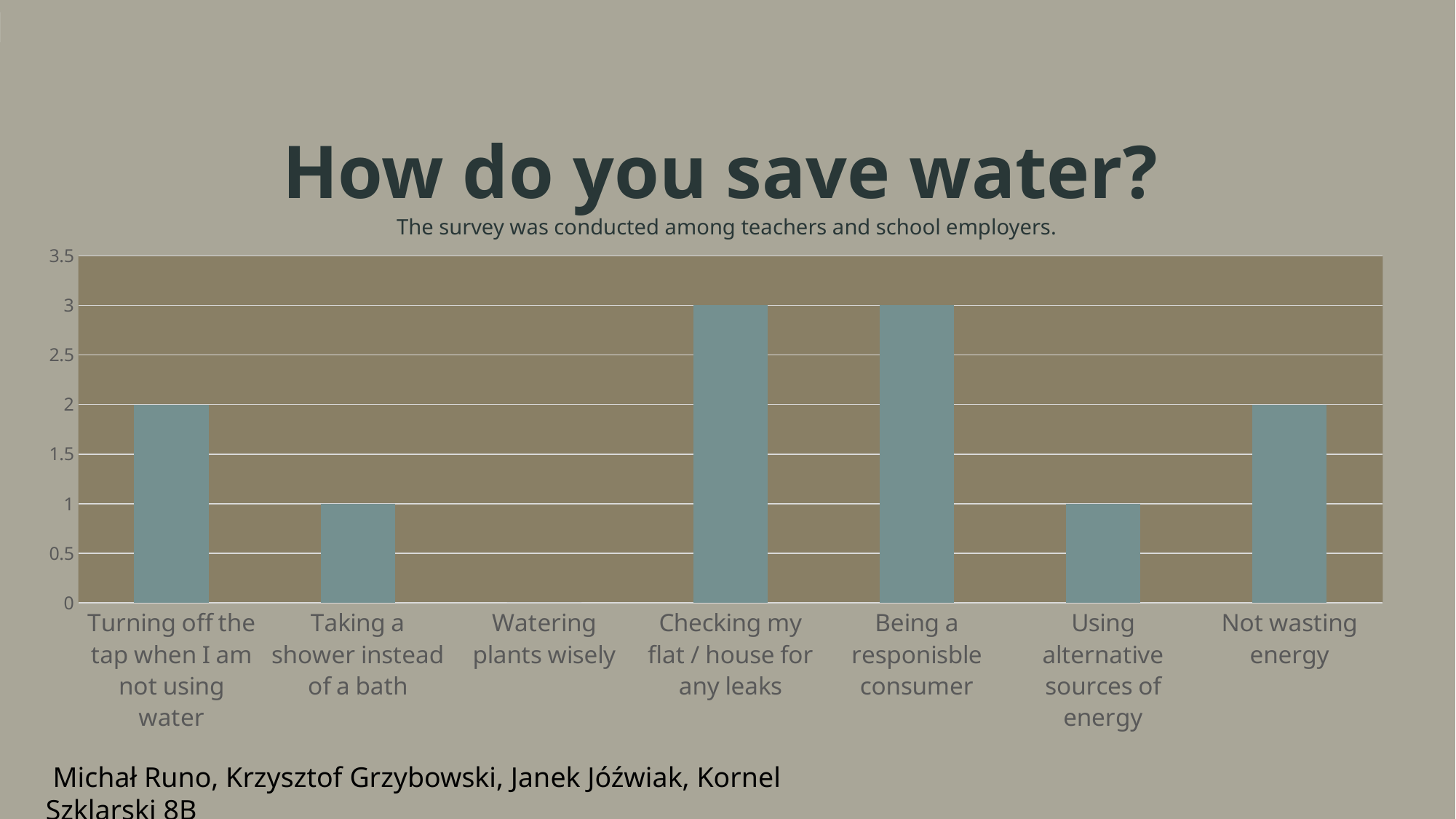
What kind of chart is shown on the slide? bar chart What is the title of the chart on the slide? How do you save water? What is the highest value reached by any bar in the chart? 3 How many categories are shown on the x axis of the chart? 7 What is the value for "Using alternative sources of energy"? 1 What is the value for "Checking my flat / house for any leaks"? 3 What is the difference between the values for "Checking my flat / house for any leaks" and "Taking a shower instead of a bath"? 2 Which has a larger value: "Turning off the tap when I am not using water" or "Taking a shower instead of a bath"? Turning off the tap when I am not using water What is the value for "Turning off the tap when I am not using water"? 2 Which category has the lowest value in the chart? Watering plants wisely Is the value for "Being a responisble consumer" greater or less than 2? greater What is the value for "Not wasting energy"? 2